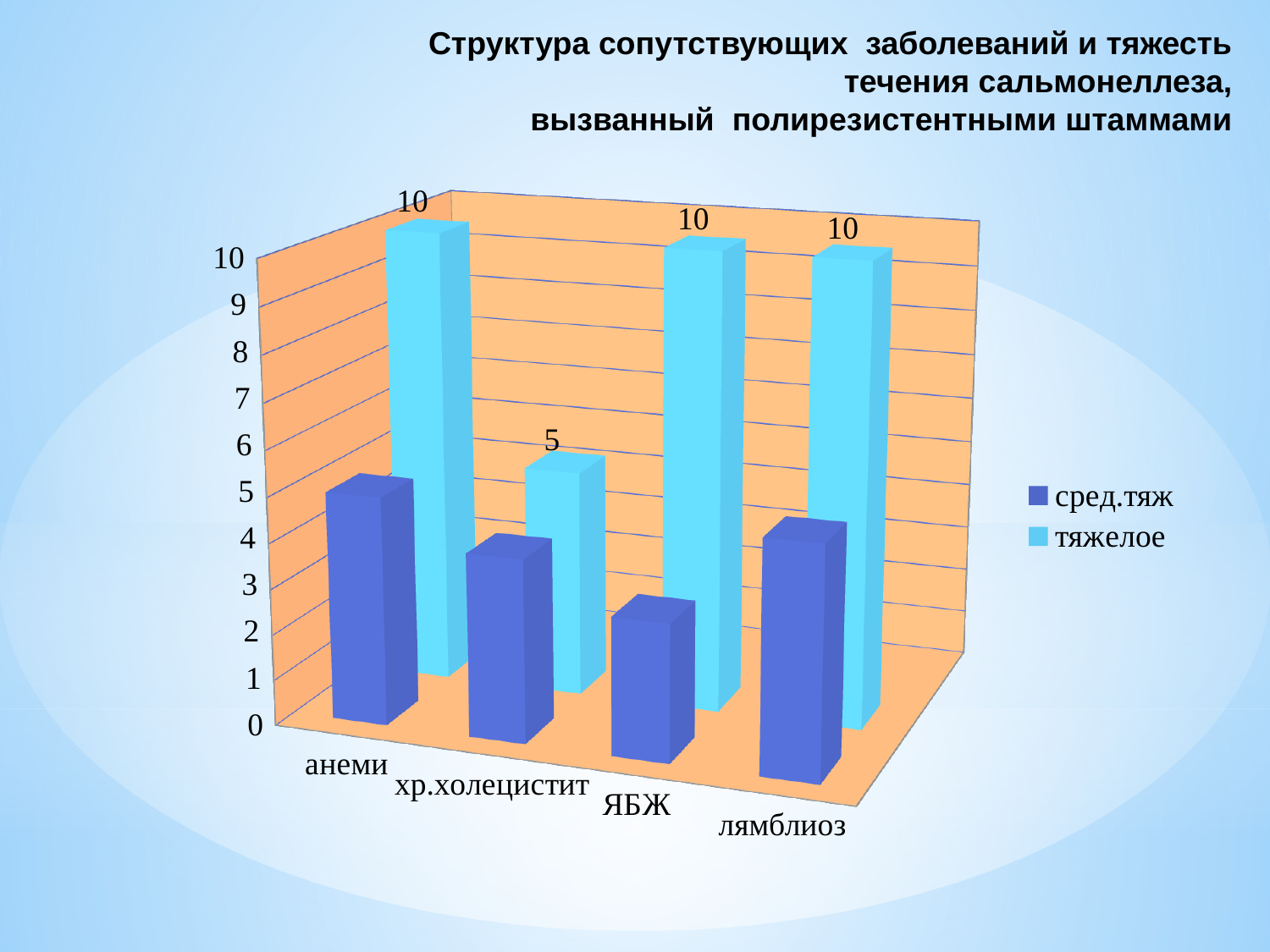
How many categories are shown on the x axis? 4 Which series is shown in light blue according to the legend? тяжелое What is the difference between the тяжелое values for анеми and хр.холецистит? 5 What kind of chart is shown on the slide? bar chart What is the value of the тяжелое series for хр.холецистит? 5 What is the value of the тяжелое series for лямблиоз? 10 Which category has the lowest value in the тяжелое series? хр.холецистит Is the сред.тяж value for анеми greater or less than 2? greater How many series does the legend list? 2 Is the сред.тяж value for ЯБЖ greater or less than 5? less What is the value of the тяжелое series for анеми? 10 Which is larger: the тяжелое value for ЯБЖ or for хр.холецистит? ЯБЖ